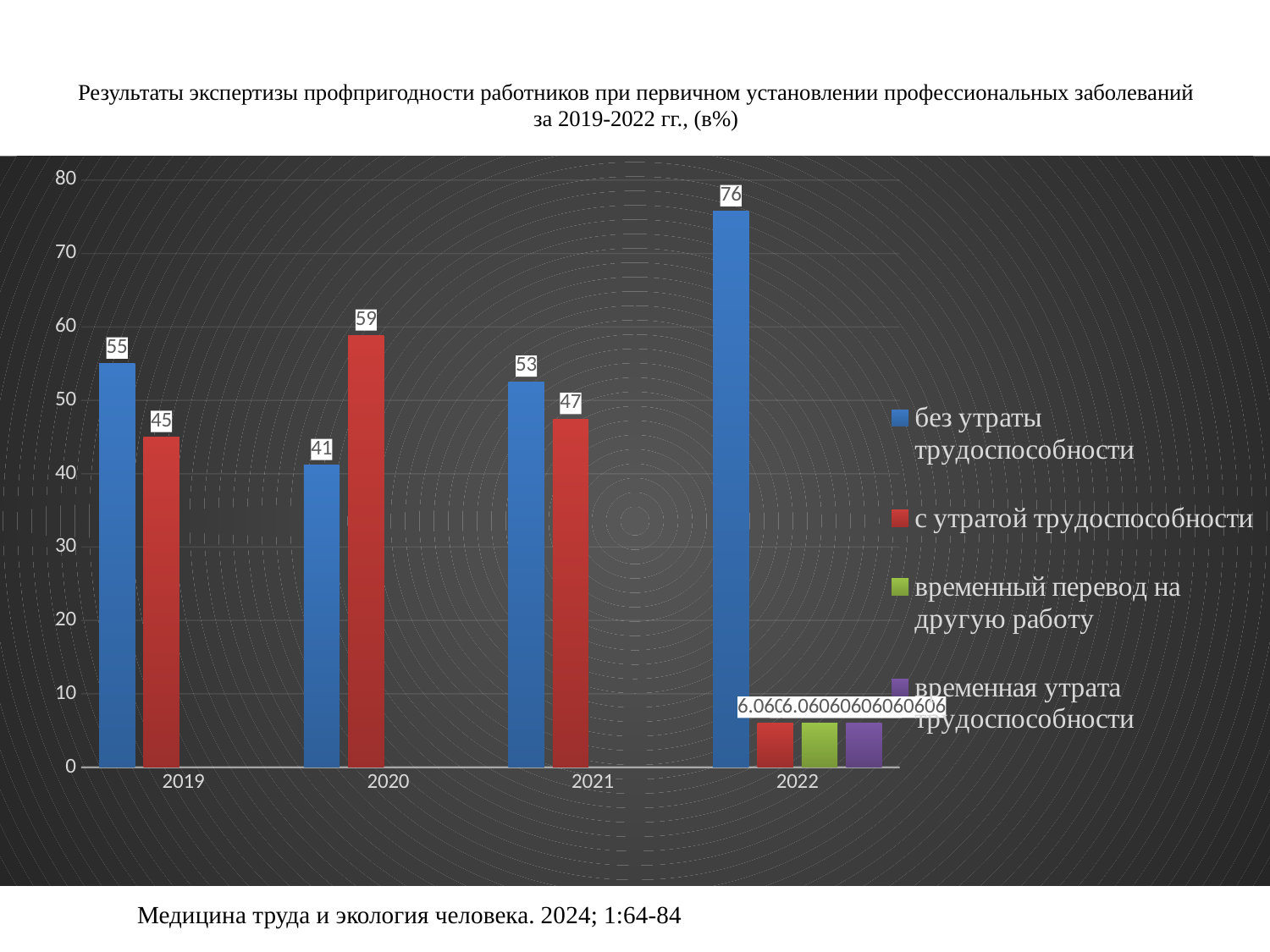
How many years are shown on the x axis? 4 Is the value for 'с утратой трудоспособности' in 2022 greater or less than 10? less What is the value for 'без утраты трудоспособности' in 2022? 76 What is the value for 'без утраты трудоспособности' in 2019? 55 What is the value for 'с утратой трудоспособности' in 2021? 47 In which year is the value for 'без утраты трудоспособности' lowest? 2020 In which year is the value for 'без утраты трудоспособности' highest? 2022 What is the difference between 'с утратой трудоспособности' and 'без утраты трудоспособности' in 2020? 18 What type of chart is shown on the slide? bar chart Which is larger in 2021: 'без утраты трудоспособности' or 'с утратой трудоспособности'? без утраты трудоспособности How many series does the legend list? 4 What is the value for 'с утратой трудоспособности' in 2020? 59